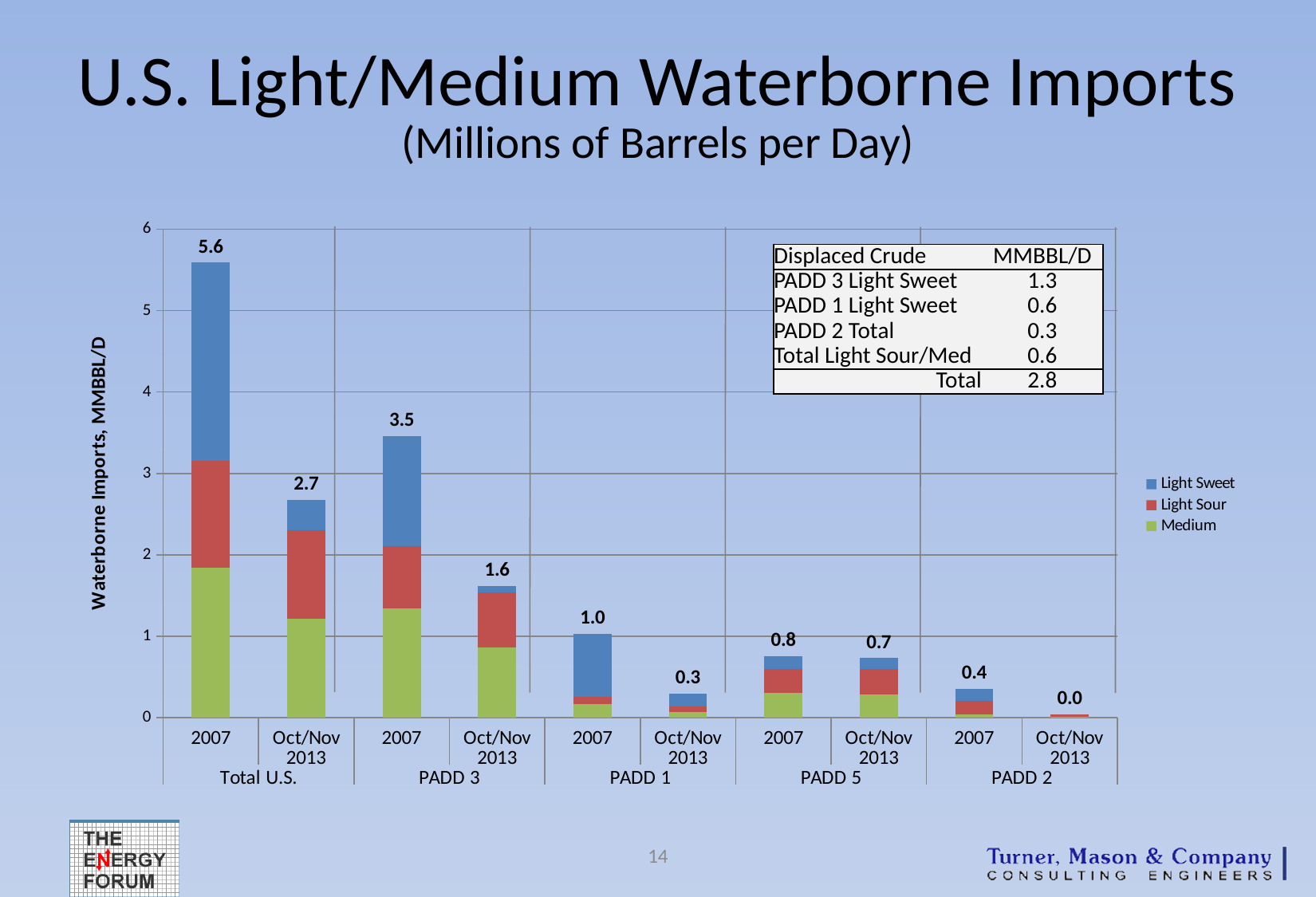
How many series does the legend list? 3 What kind of chart is shown on the slide? Stacked bar chart Which series is shown in green in the legend? Medium How many bars are plotted in the chart? 10 What is the total waterborne imports value for Total U.S. in 2007? 5.6 Which is larger, the PADD 3 2007 total or the PADD 1 2007 total? PADD 3 2007 What is the total value shown for PADD 5 in Oct/Nov 2013? 0.7 What is the difference between the Total U.S. totals for 2007 and Oct/Nov 2013? 2.9 What is the total value shown for PADD 3 in Oct/Nov 2013? 1.6 Which bar has the lowest total value? PADD 2 Oct/Nov 2013 Which bar has the highest total value? Total U.S. 2007 Is the Medium segment for PADD 3 in 2007 greater or less than 1? greater